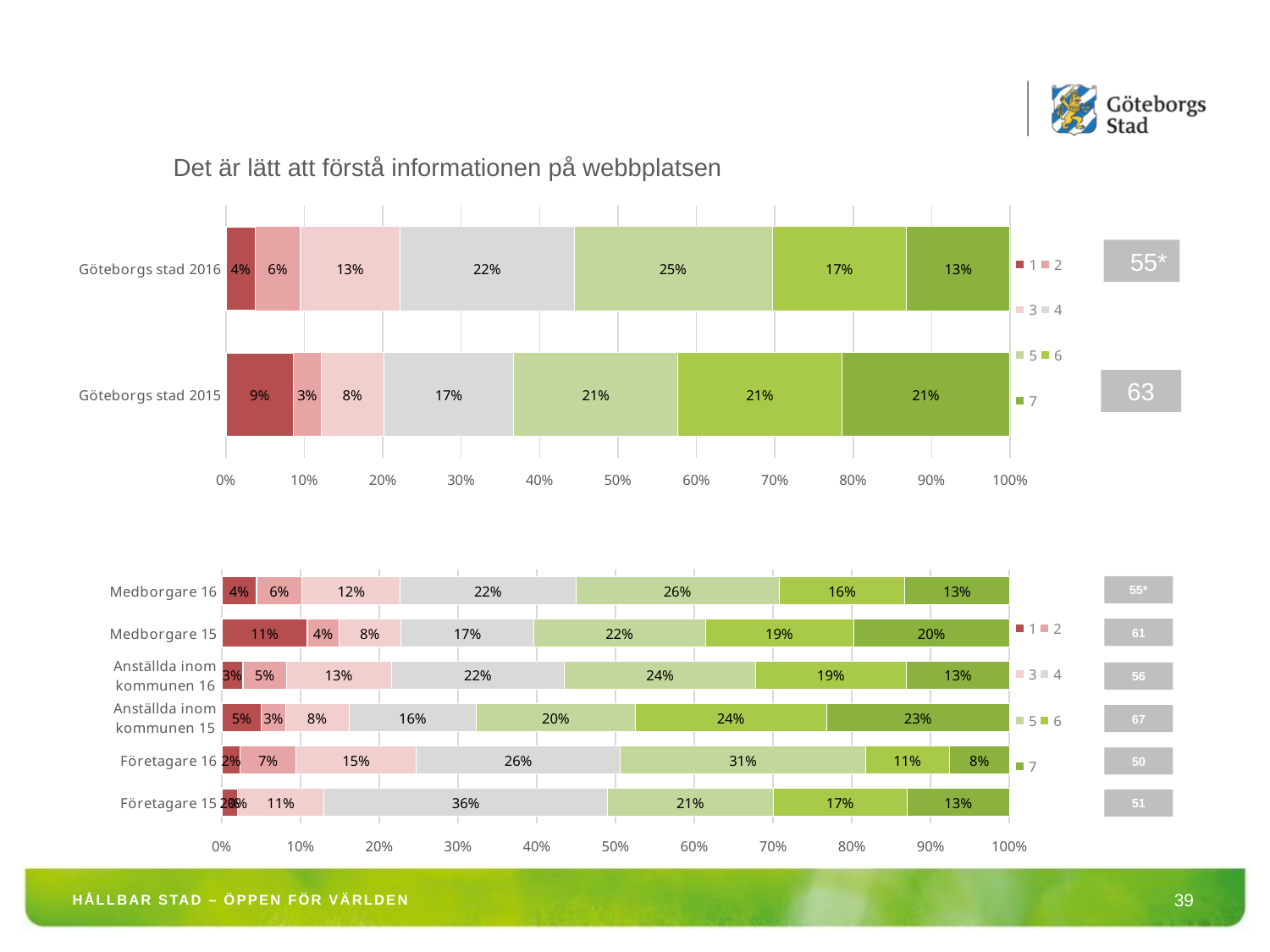
In the top chart, what is the value of series 7 for Göteborgs stad 2015? 21% In the top chart, what is the value of series 5 for Göteborgs stad 2016? 25% In the bottom chart, what is the value of series 4 for Företagare 15? 36% How many categories are shown in the bottom chart? 6 How many series does the legend of the top chart list? 7 In the top chart, what is the difference between the series 4 value for Göteborgs stad 2016 and for Göteborgs stad 2015? 5 percentage points What kind of chart is the top chart on the slide? Stacked bar chart In the bottom chart, what is the value of series 5 for Företagare 16? 31% What is the title shown above the top chart? Det är lätt att förstå informationen på webbplatsen In the bottom chart, which has the larger series 7 value: Medborgare 16 or Medborgare 15? Medborgare 15 How many categories are shown in the top chart? 2 In the bottom chart, what is the value of series 6 for Anställda inom kommunen 15? 24%